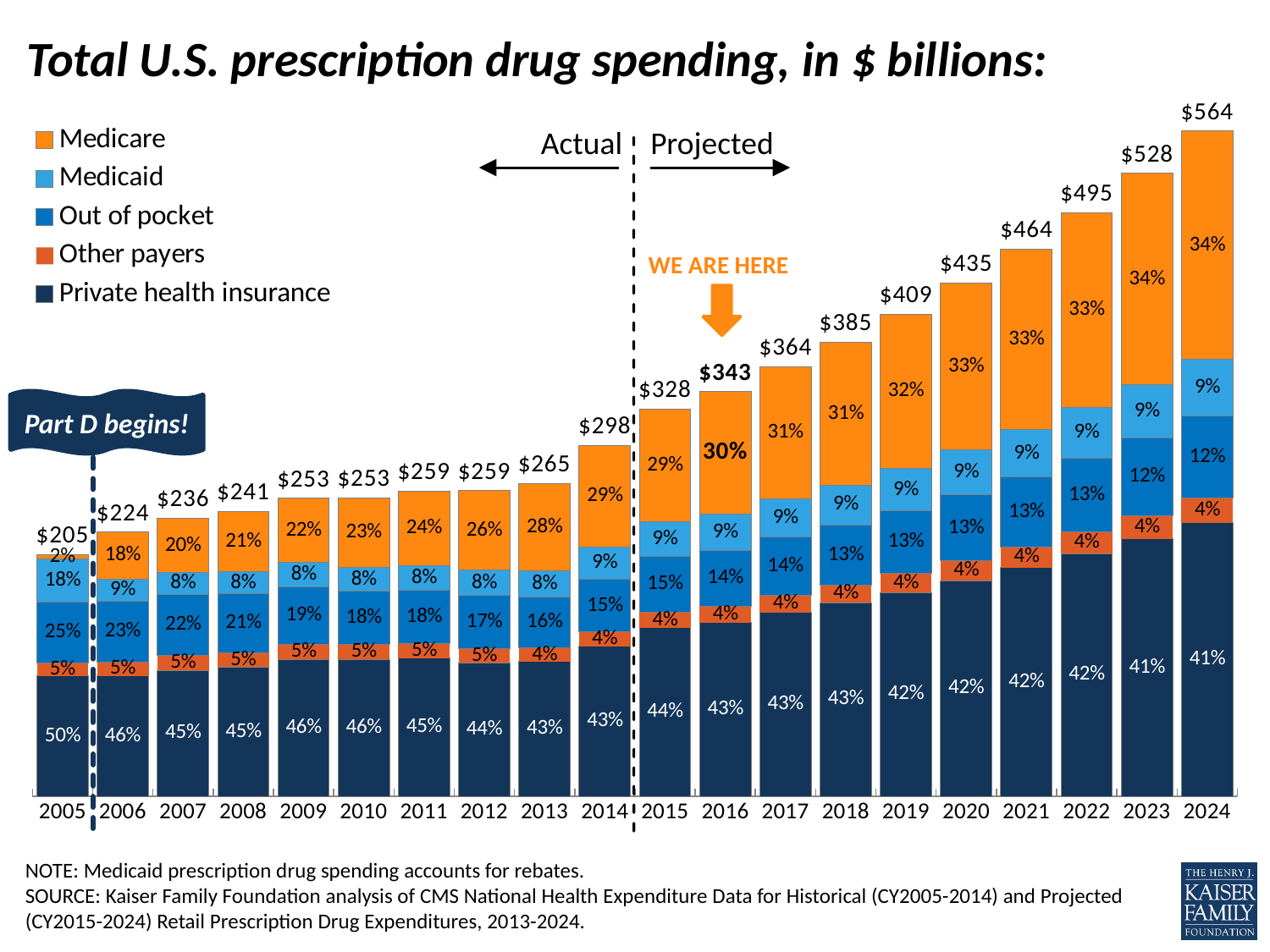
What kind of chart is shown on the slide? Stacked bar chart What is the Out of pocket share of spending in 2014? 15% What is the difference in total spending between 2024 and 2014? $266 Which year has the lowest total prescription drug spending? 2005 How many years are shown on the x axis? 20 How many series does the legend list? 5 What is the total U.S. prescription drug spending shown for 2016? $343 What percentage of prescription drug spending does Medicare account for in 2024? 34% Is the Medicare share of spending larger in 2013 or in 2006? 2013 What share of spending is attributed to Private health insurance in 2005? 50% Which year has the highest total prescription drug spending? 2024 Does the Out of pocket share of spending rise or fall from 2005 to 2024? Fall